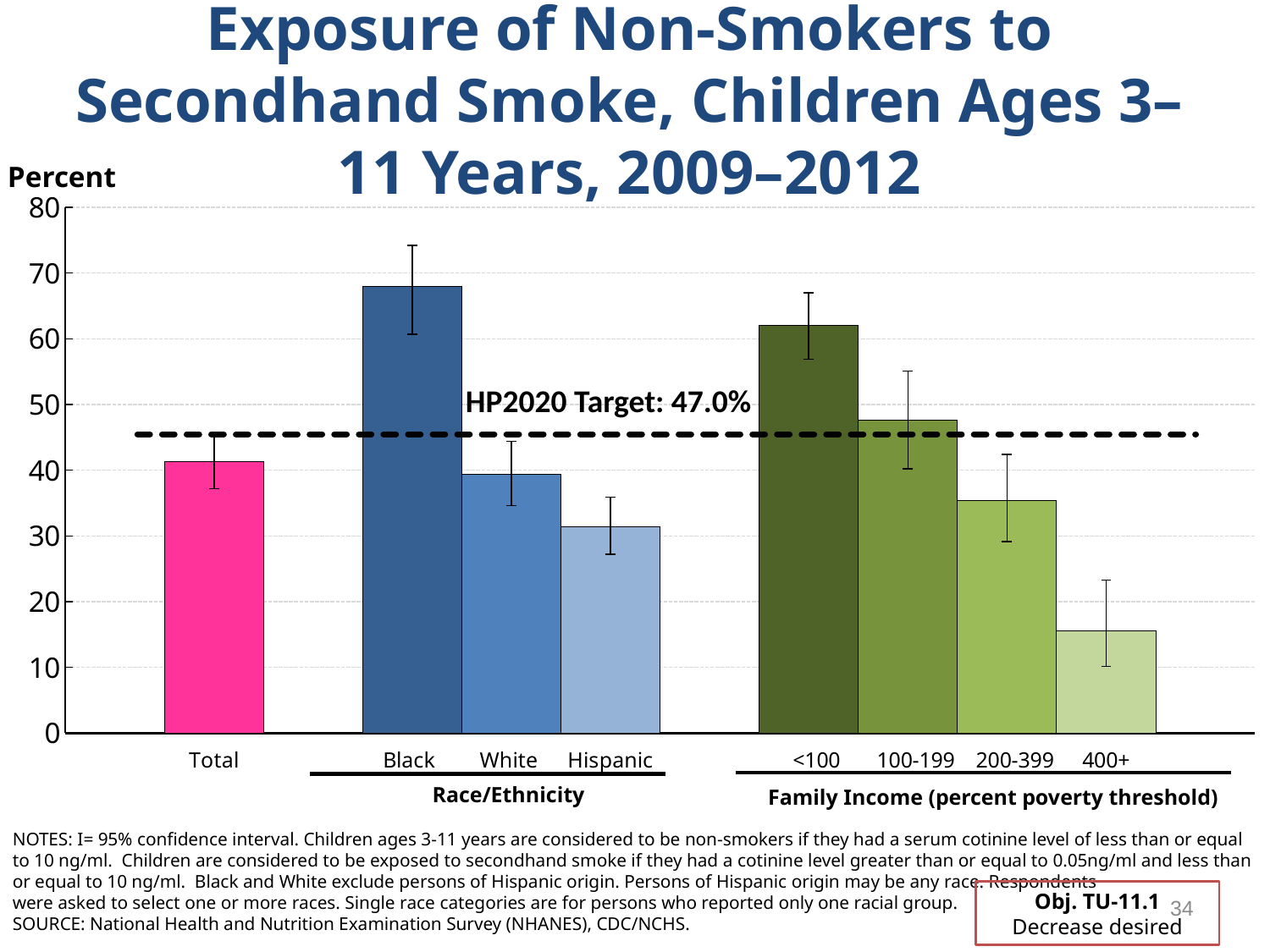
Is the value for the 400+ family income group greater or less than 20? less Which category has the highest percentage of children exposed to secondhand smoke? Black Is the value for Black greater or less than 60? greater Which is larger, the value for the 200-399 group or the value for the <100 group? <100 What is the HP2020 Target value shown on the chart? 47.0% Which category has the lowest percentage of children exposed to secondhand smoke? 400+ Is the value for Hispanic greater or less than 40? less How many bars (categories) are plotted in the chart? 8 What are the two group labels shown beneath the x-axis categories? Race/Ethnicity; Family Income (percent poverty threshold) Which is larger, the value for White or the value for Hispanic? White What kind of chart is shown on the slide? bar chart